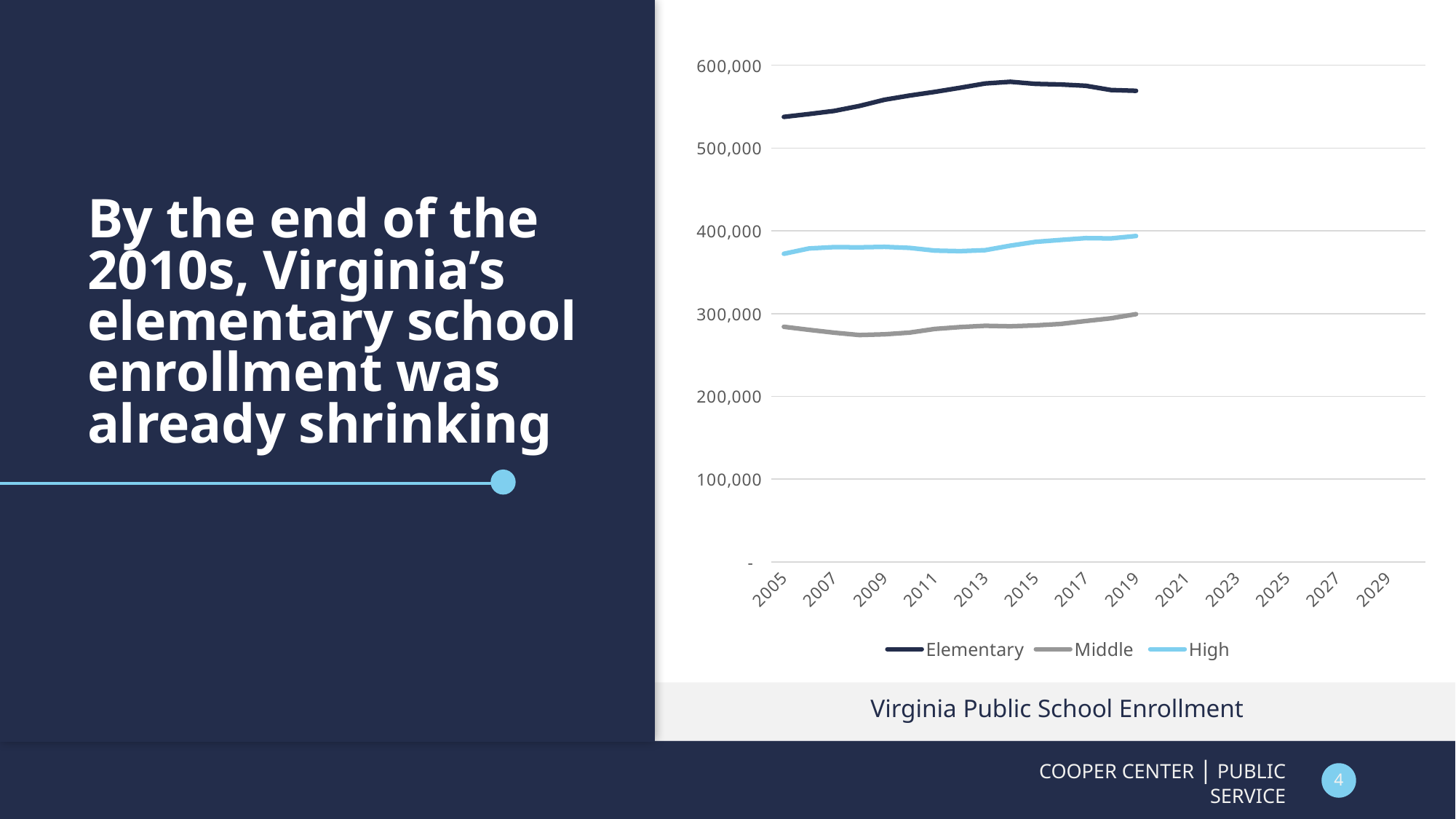
In 2019, which is larger, Elementary enrollment or High enrollment? Elementary Is the Middle enrollment in 2009 greater or less than 300,000? less Does the Elementary line rise or fall between 2014 and 2019? fall How many series does the legend list? 3 Is the Elementary enrollment in 2005 greater or less than 500,000? greater Which series has the lowest enrollment throughout the chart? Middle Which series has the highest enrollment throughout the chart? Elementary What is the title shown beneath the chart? Virginia Public School Enrollment What kind of chart is shown on the slide? line chart Is the High enrollment in 2005 greater or less than 400,000? less What are the three series named in the legend? Elementary, Middle, High